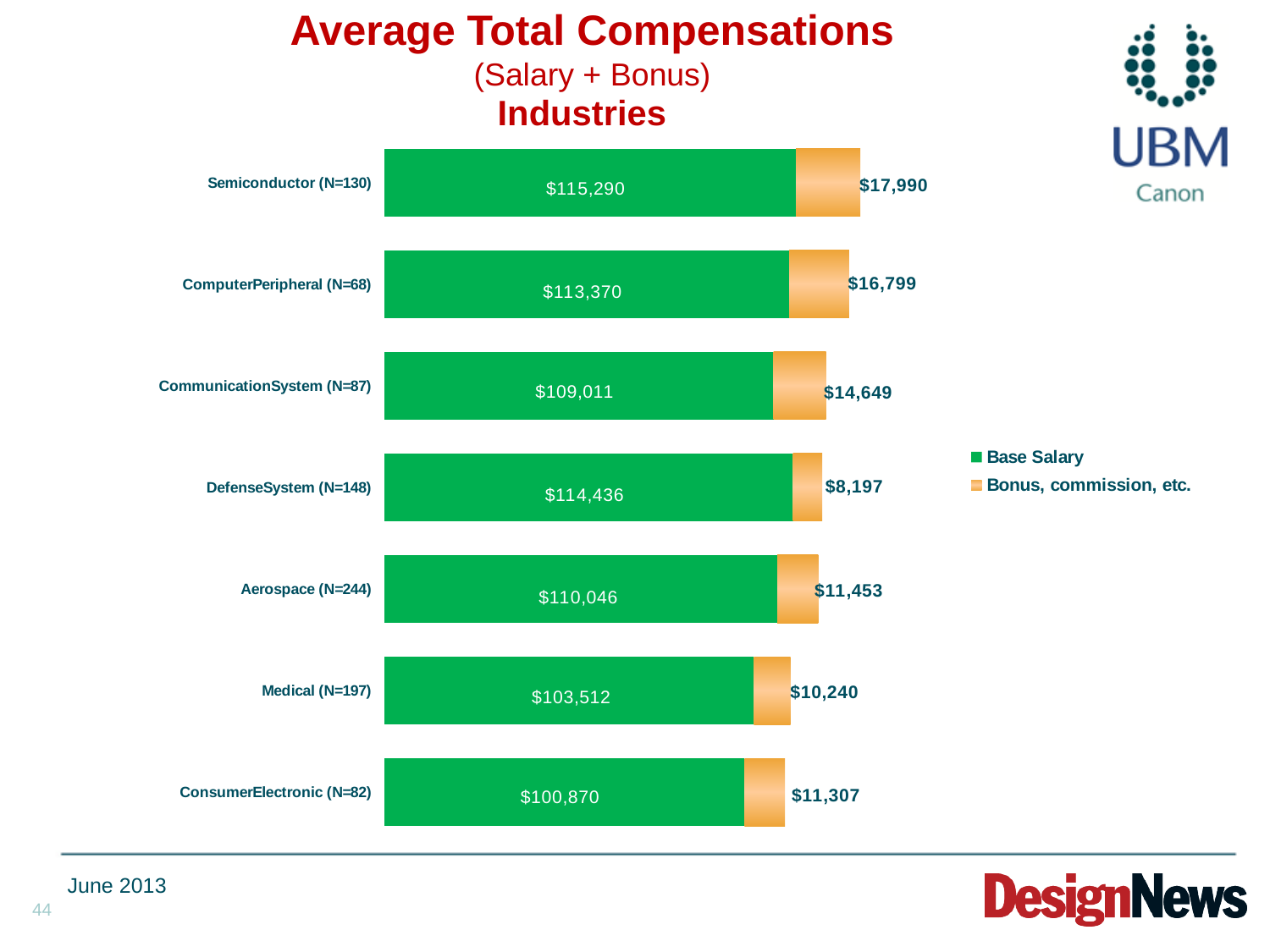
Which industry has the lowest Base Salary value? ConsumerElectronic (N=82) Which industry has the lowest Bonus, commission, etc. value? DefenseSystem (N=148) What is the total compensation (Base Salary plus Bonus, commission, etc.) for Semiconductor (N=130)? $133,280 What is the Bonus, commission, etc. value for DefenseSystem (N=148)? $8,197 What kind of chart is shown on the slide? Stacked bar chart What is the Base Salary value for Medical (N=197)? $103,512 How many series does the legend list? 2 Which industry has the highest Bonus, commission, etc. value? Semiconductor (N=130) Which has a larger Base Salary, Aerospace (N=244) or Medical (N=197)? Aerospace (N=244) What is the Base Salary value for Semiconductor (N=130)? $115,290 What is the difference between the Base Salary for Semiconductor (N=130) and ConsumerElectronic (N=82)? $14,420 How many industries are shown in the chart? 7